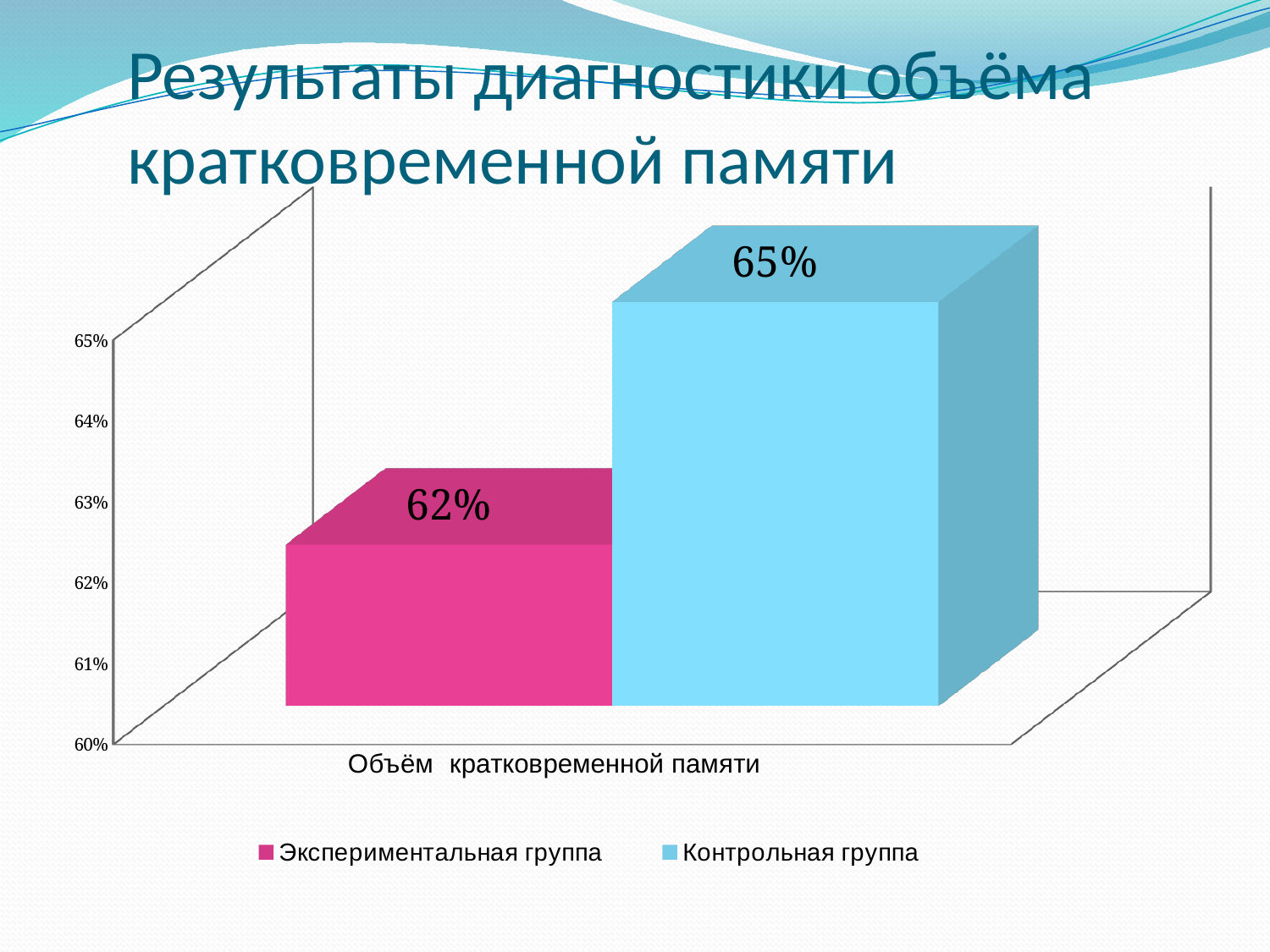
Which is larger, the value for Экспериментальная группа or the value for Контрольная группа? Контрольная группа Which series has the highest value? Контрольная группа What kind of chart is shown on the slide? bar chart What colour is the bar for Контрольная группа? light blue What is the difference between the values for Контрольная группа and Экспериментальная группа? 3% How many series does the legend list? 2 What is the value for Экспериментальная группа? 62% Which series has the lowest value? Экспериментальная группа What is the category label on the x axis? Объём кратковременной памяти What is the value for Контрольная группа? 65% Is the value for Экспериментальная группа greater or less than 64%? less